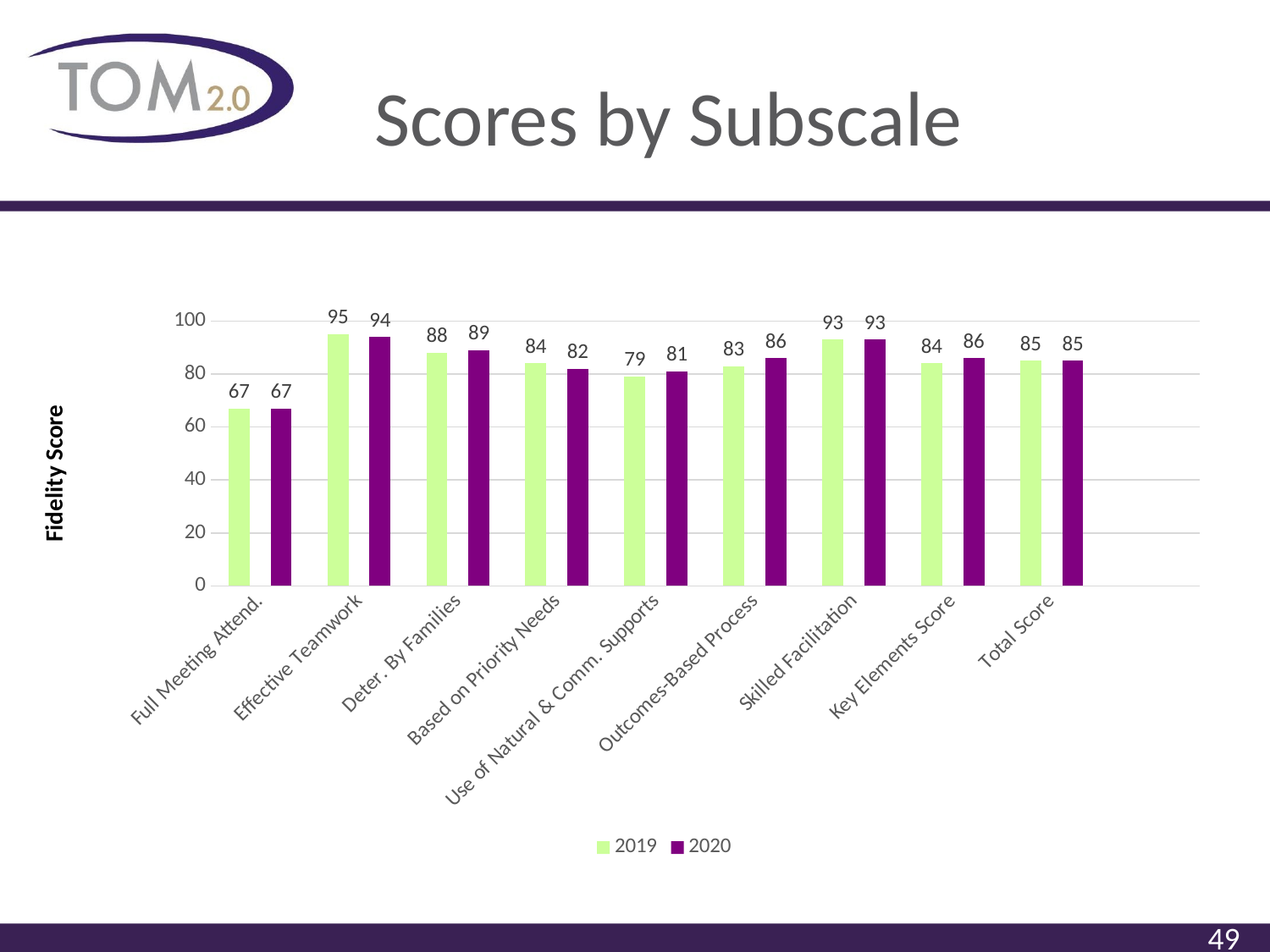
What is the 2019 value for Effective Teamwork? 95 What is the difference between the 2019 and 2020 values for Outcomes-Based Process? 3 How many series does the legend list? 2 Is the 2019 value for Skilled Facilitation greater or less than 80? greater What kind of chart is shown on the slide? bar chart Which is larger for Based on Priority Needs, the 2019 value or the 2020 value? 2019 How many categories are shown on the x axis? 9 Which category has the highest 2020 value? Effective Teamwork What is the 2020 value for Outcomes-Based Process? 86 What is the 2020 value for Use of Natural & Comm. Supports? 81 What is the label of the vertical axis? Fidelity Score Which category has the lowest 2019 value? Full Meeting Attend.